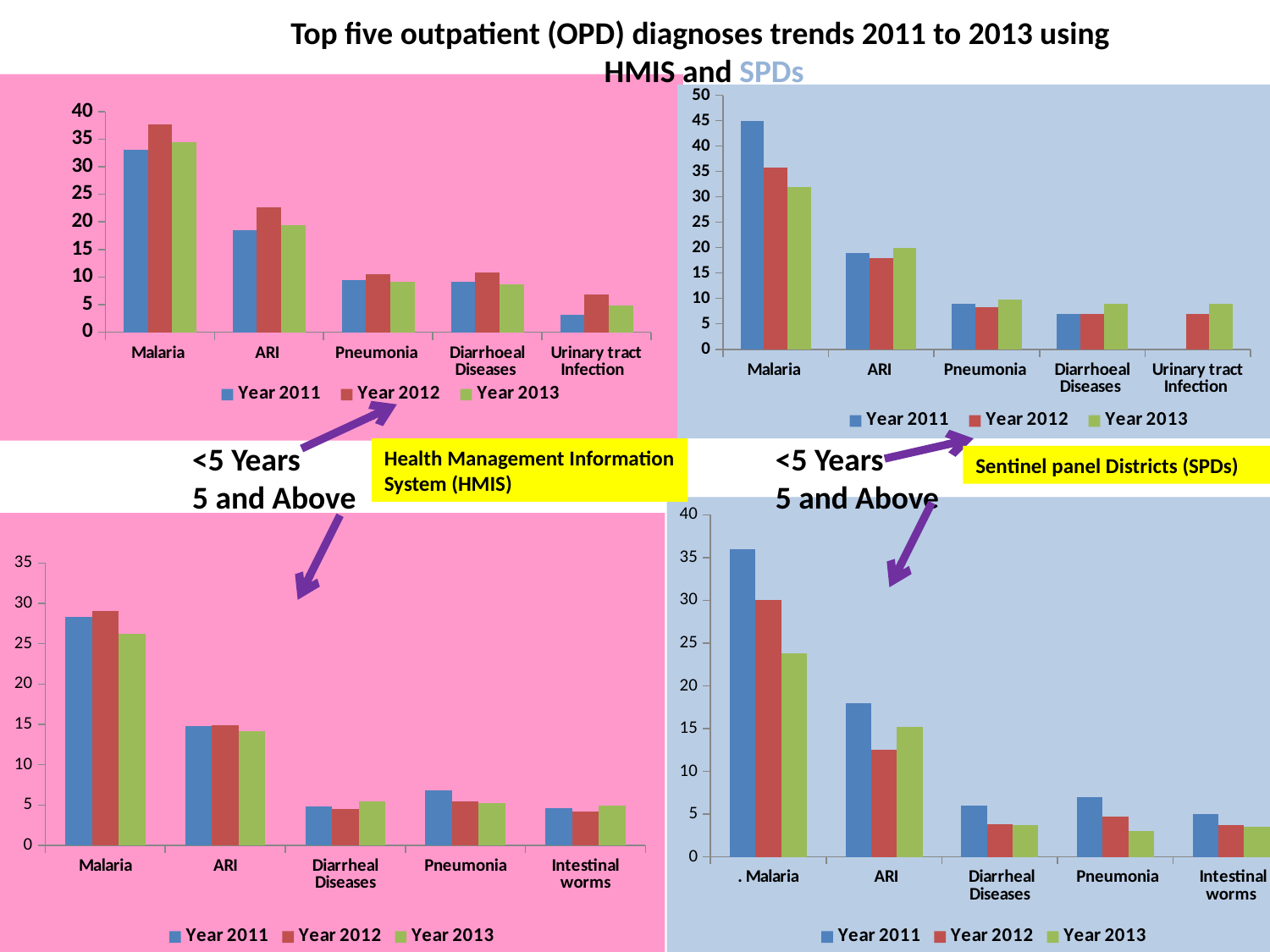
In the top-right chart, is the Year 2011 value for Malaria greater or less than 40? greater In the bottom-left chart, is the Year 2013 value for Malaria greater or less than 25? greater How many series does the legend of the top-left chart list? 3 How many diagnosis categories are shown on the x axis of the bottom-left chart? 5 In the top-right chart, which is larger for Year 2011: Malaria or ARI? Malaria In the top-right chart, do the Malaria values rise or fall from Year 2011 to Year 2013? fall In the top-left chart, which category has the highest value for Year 2012? Malaria How many diagnosis categories are shown on the x axis of the top-left chart? 5 What are the legend entries of the bottom-right chart? Year 2011, Year 2012, Year 2013 In the bottom-right chart, is the Year 2012 value for ARI greater or less than 15? less What kind of chart is the top-left chart on the slide? bar chart